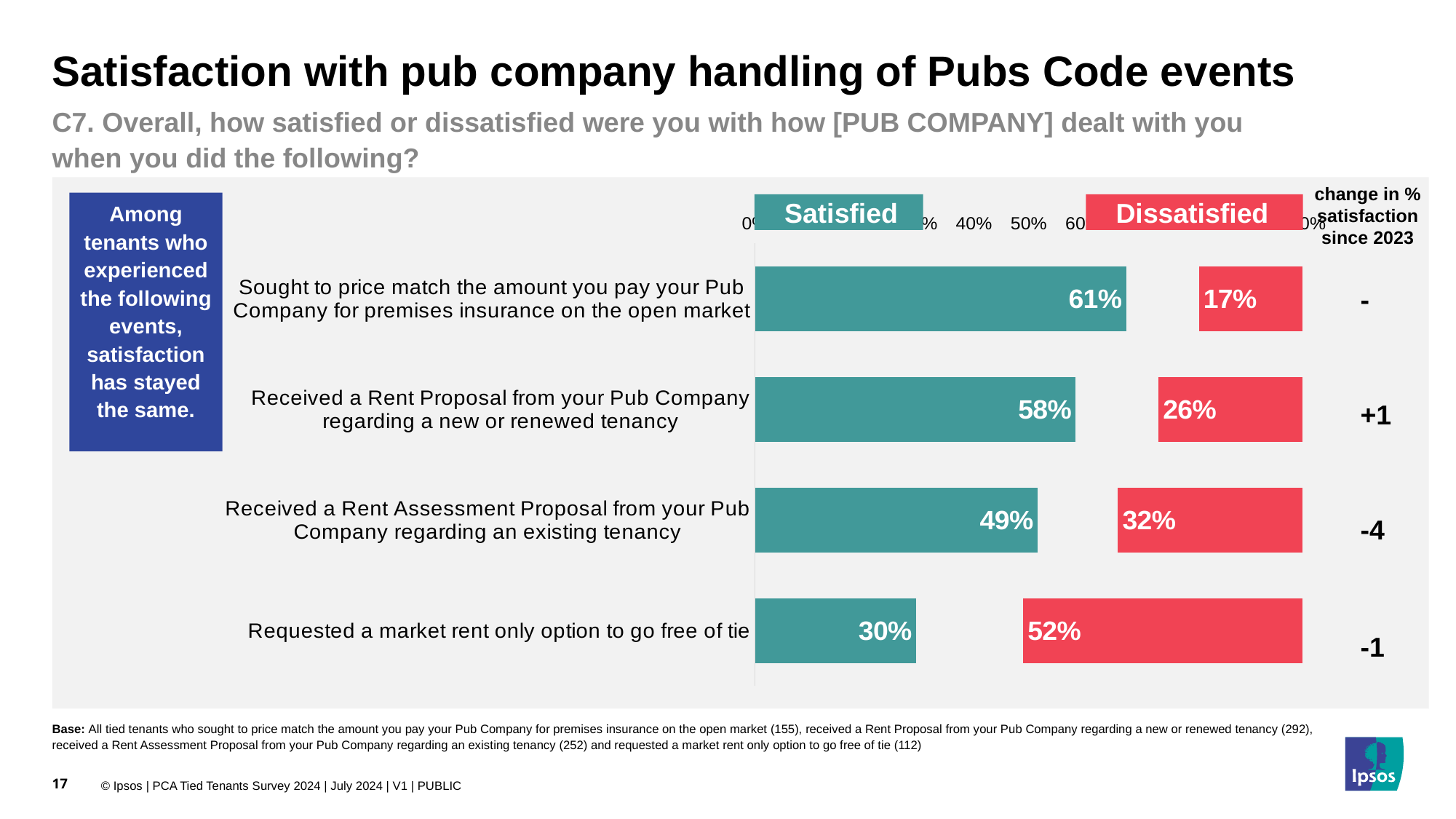
How many series does the chart show? 2 For tenants who requested a market rent only option to go free of tie, which is larger: the satisfied or the dissatisfied percentage? Dissatisfied Which event has the lowest satisfied percentage? Requested a market rent only option to go free of tie How many events are shown in the chart? 4 What is the change in % satisfaction since 2023 for tenants who received a Rent Assessment Proposal regarding an existing tenancy? -4 Which colour represents the Dissatisfied series in the chart? Red What is the difference between the satisfied and dissatisfied percentages for tenants who received a Rent Assessment Proposal regarding an existing tenancy? 17 percentage points What is the dissatisfied percentage for tenants who received a Rent Proposal regarding a new or renewed tenancy? 26% What type of chart is shown on the slide? Bar chart Which event has the highest satisfied percentage? Sought to price match the amount you pay your Pub Company for premises insurance on the open market What percentage of tenants were satisfied with how the pub company dealt with them when they sought to price match the amount paid for premises insurance on the open market? 61% What percentage of tenants were dissatisfied with how the pub company dealt with them when they requested a market rent only option to go free of tie? 52%